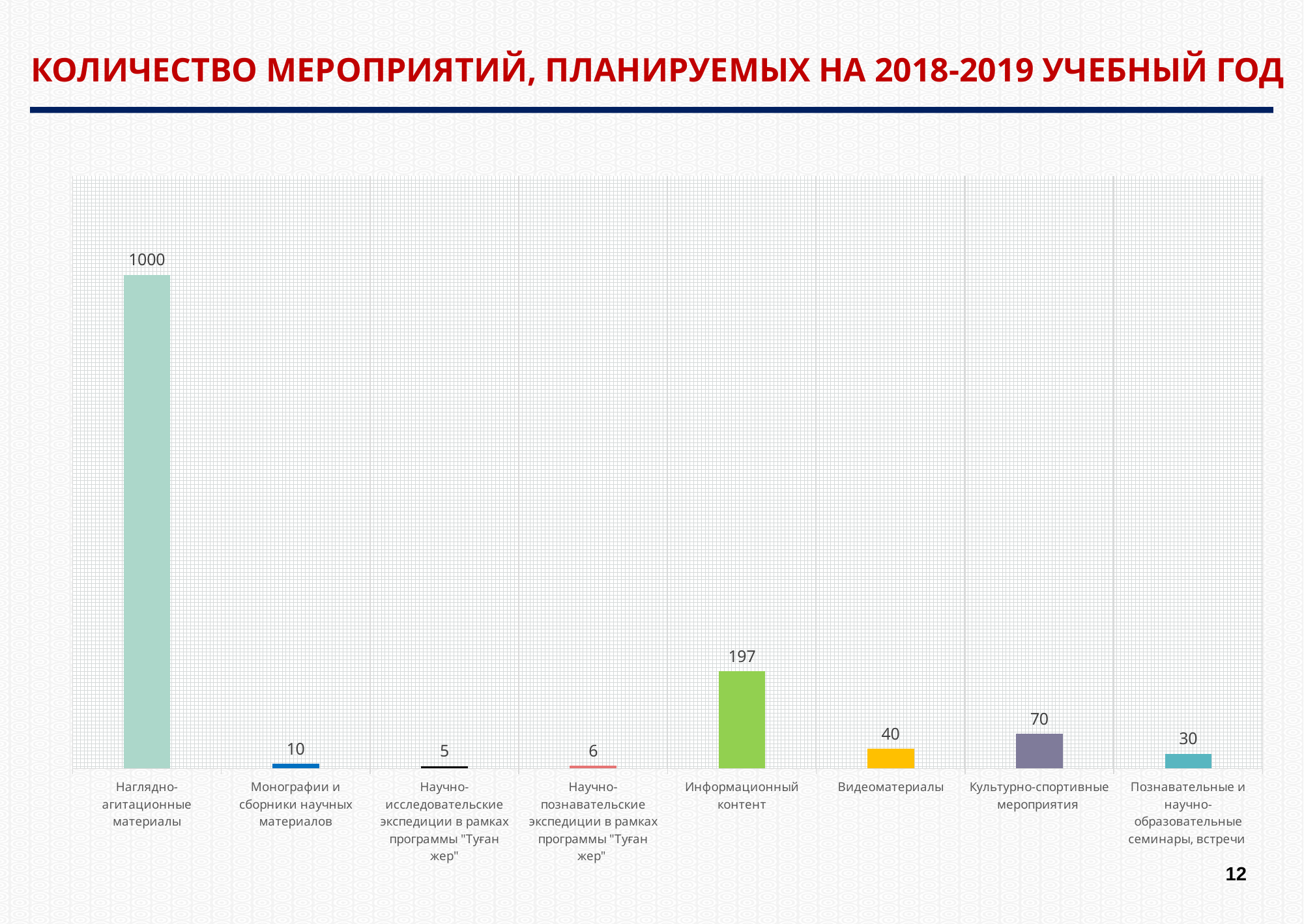
Which category has the highest value? Наглядно-агитационные материалы What is the value for Культурно-спортивные мероприятия? 70 What is the value for Видеоматериалы? 40 What is the difference between the values for Информационный контент and Видеоматериалы? 157 How many categories are shown in the chart? 8 What kind of chart is shown on the slide? Bar chart Which is larger: the value for Культурно-спортивные мероприятия or the value for Познавательные и научно-образовательные семинары, встречи? Культурно-спортивные мероприятия Which category has the lowest value? Научно-исследовательские экспедиции в рамках программы "Туған жер" What is the title of the slide? КОЛИЧЕСТВО МЕРОПРИЯТИЙ, ПЛАНИРУЕМЫХ НА 2018-2019 УЧЕБНЫЙ ГОД What is the value for Информационный контент? 197 What is the value for Познавательные и научно-образовательные семинары, встречи? 30 What is the value for Наглядно-агитационные материалы? 1000